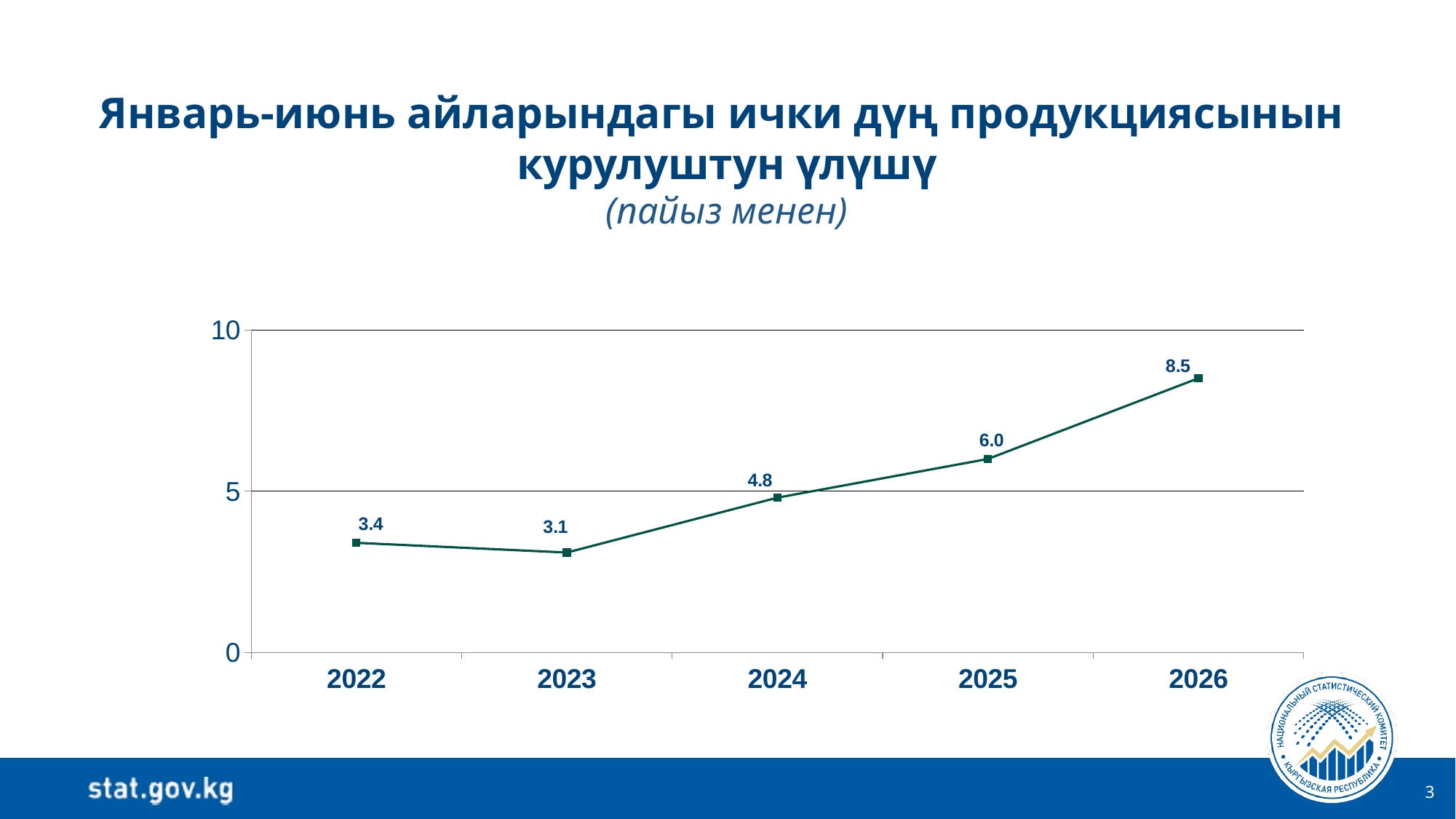
What is the difference between the values for 2026 and 2025? 2.5 Which is larger, the value for 2022 or the value for 2023? 2022 How many years are plotted on the chart? 5 What is the value for 2022? 3.4 Is the value for 2024 greater or less than 5? less What is the value for 2024? 4.8 Which year has the lowest value? 2023 Which year has the highest value? 2026 What is the value for 2026? 8.5 What kind of chart is shown on the slide? line chart What is the value for 2023? 3.1 What is the value for 2025? 6.0